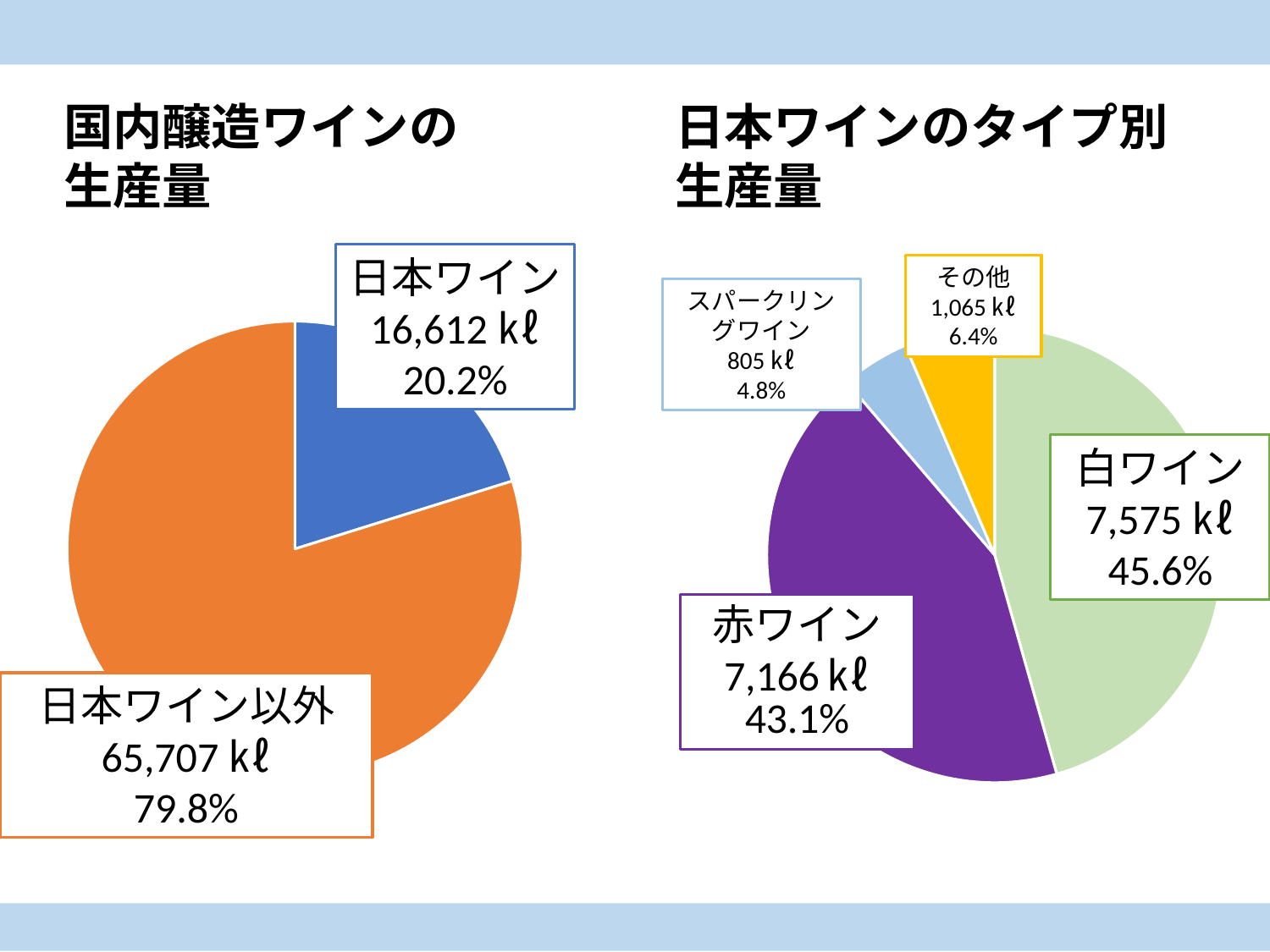
In the 日本ワインのタイプ別生産量 chart on the right, which category has the smallest production volume? スパークリングワイン In the 国内醸造ワインの生産量 chart on the left, what share of the pie does 日本ワイン以外 represent? 79.8% In the 日本ワインのタイプ別生産量 chart on the right, what is the difference in production volume between 白ワイン and 赤ワイン? 409 kℓ In the 日本ワインのタイプ別生産量 chart on the right, which category has the largest production volume? 白ワイン In the 国内醸造ワインの生産量 chart on the left, what is the production volume for 日本ワイン以外? 65,707 kℓ How many categories are shown in the 日本ワインのタイプ別生産量 chart on the right? 4 What kind of chart is the 国内醸造ワインの生産量 chart on the left? Pie chart In the 日本ワインのタイプ別生産量 chart on the right, what is the production volume for スパークリングワイン? 805 kℓ In the 日本ワインのタイプ別生産量 chart on the right, what share of the pie does 赤ワイン represent? 43.1% In the 日本ワインのタイプ別生産量 chart on the right, what is the production volume for 白ワイン? 7,575 kℓ How many slices does the 国内醸造ワインの生産量 chart on the left have? 2 In the 国内醸造ワインの生産量 chart on the left, what is the production volume for 日本ワイン? 16,612 kℓ